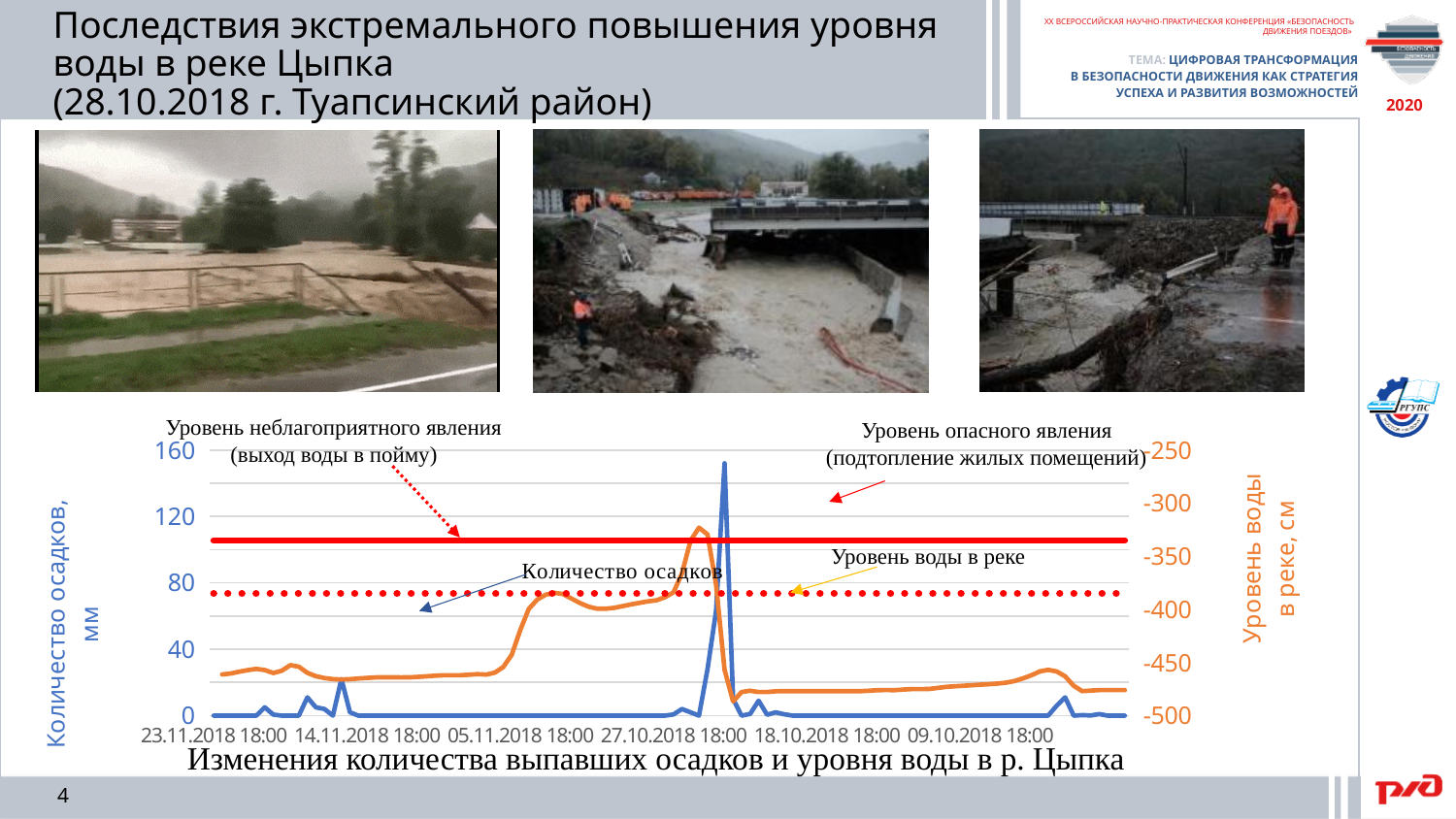
What kind of chart is shown at the bottom of the slide? line chart On the left axis scale, is the solid red line 'Уровень опасного явления' greater or less than 80? greater How many date labels are shown on the x axis of the chart? 6 On the right axis scale, is the peak of the water level line (Уровень воды в реке) greater or less than -400? greater Between the x-axis labels 05.11.2018 18:00 and 27.10.2018 18:00, does the water level line (Уровень воды в реке) rise or fall? rise Is the precipitation value at 23.11.2018 18:00 greater or less than 40? less Which line reaches the higher point on the chart relative to the left axis: the precipitation line or the water level line? the precipitation line (Количество осадков) What is the caption/title of the chart at the bottom of the slide? Изменения количества выпавших осадков и уровня воды в р. Цыпка What is the label of the left vertical axis of the chart? Количество осадков, мм How many horizontal red reference lines are drawn on the chart? 2